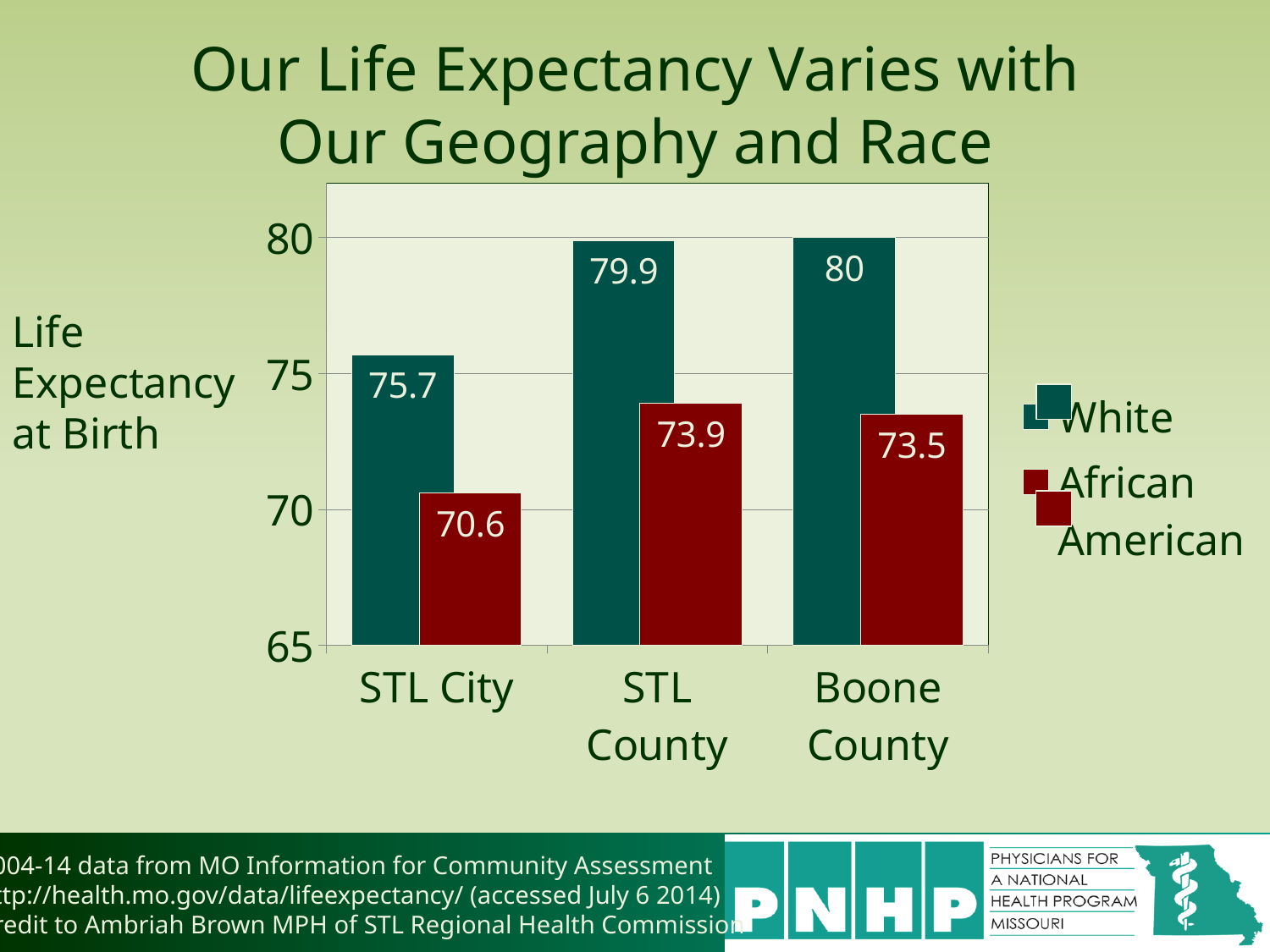
Which location has the lowest life expectancy for African American residents? STL City What is the life expectancy at birth for African American residents of STL County? 73.9 How many series does the legend list? 2 Which location has the highest life expectancy for White residents? Boone County How many locations are shown on the x axis? 3 What colour are the bars for the African American series? Dark red Which is larger: the African American life expectancy in STL County or in Boone County? STL County What is the life expectancy at birth for White residents of STL City? 75.7 What kind of chart is shown on the slide? Bar chart What is the life expectancy at birth for African American residents of Boone County? 73.5 What is the difference between White and African American life expectancy in Boone County? 6.5 What is the difference between White and African American life expectancy in STL City? 5.1